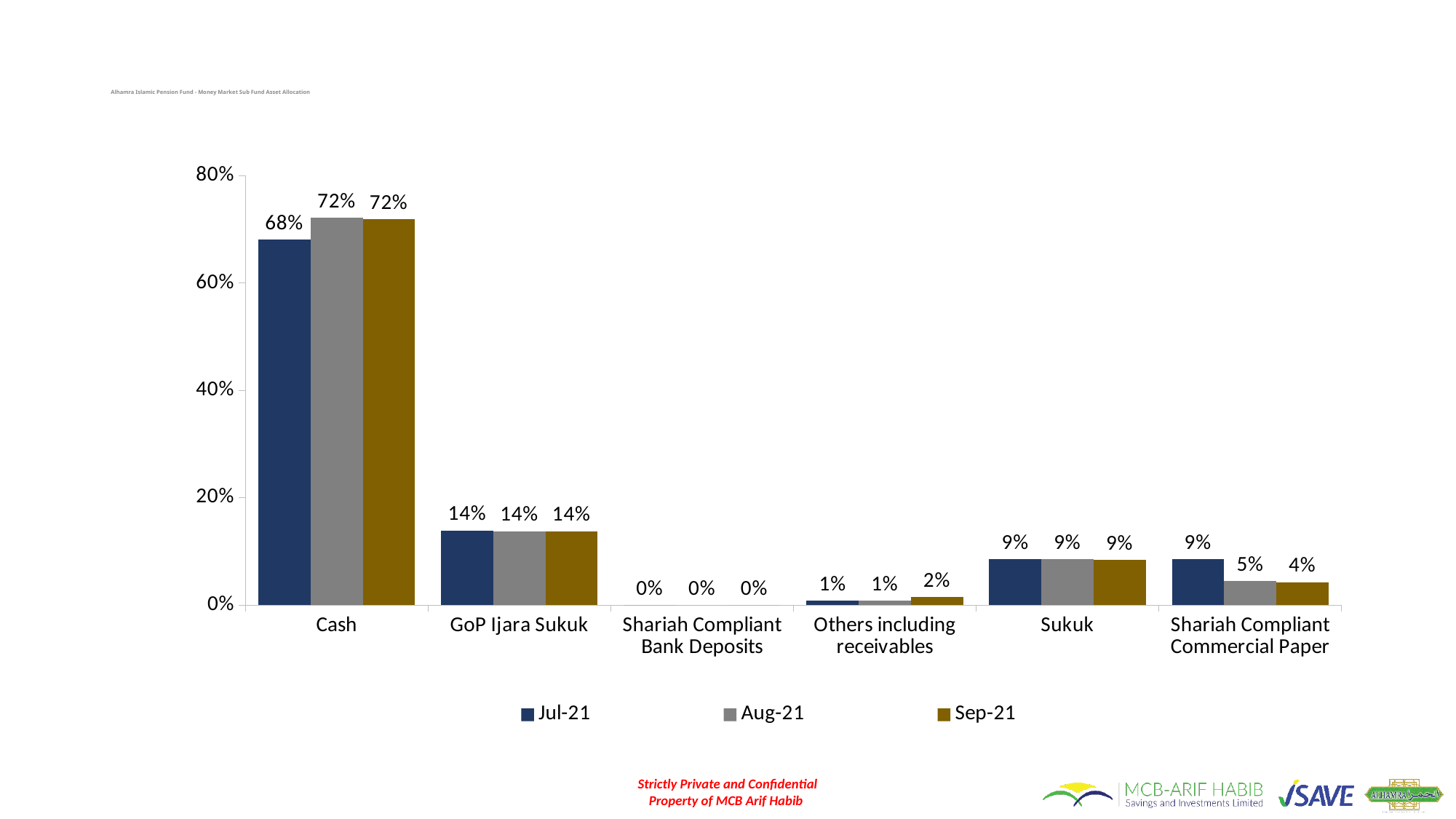
What is the value for Shariah Compliant Commercial Paper in Sep-21? 4% What is the value for Others including receivables in Sep-21? 2% How many categories are shown on the x axis? 6 Which category has the lowest value in Jul-21? Shariah Compliant Bank Deposits Which category has the highest value in Aug-21? Cash What kind of chart is shown on the slide? Bar chart What is the difference between the Cash values for Aug-21 and Jul-21? 4% What is the difference between the Shariah Compliant Commercial Paper values for Jul-21 and Sep-21? 5% Which is larger for Shariah Compliant Commercial Paper: the Jul-21 value or the Aug-21 value? Jul-21 What is the value for Cash in Jul-21? 68% Is the value for Cash in Sep-21 greater or less than 60%? greater How many series does the legend list? 3